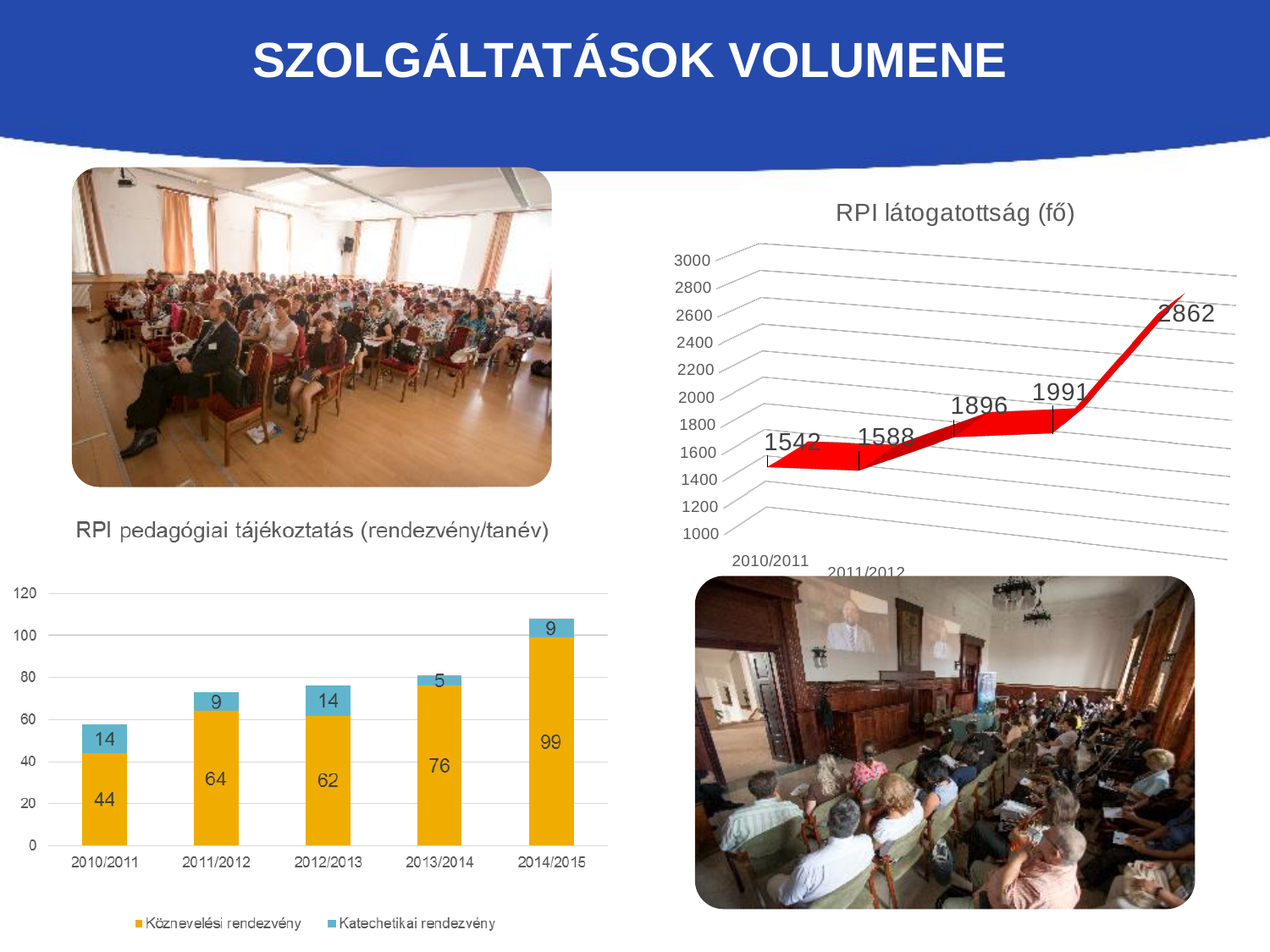
In the chart titled "RPI látogatottság (fő)", do the values rise or fall from left to right? Rise In the chart titled "RPI látogatottság (fő)", what is the highest value shown? 2862 In the chart titled "RPI látogatottság (fő)", what is the value for 2010/2011? 1542 In the chart titled "RPI pedagógiai tájékoztatás (rendezvény/tanév)", how many years are shown on the x axis? 5 In the chart titled "RPI pedagógiai tájékoztatás (rendezvény/tanév)", how many series does the legend list? 2 In the chart titled "RPI pedagógiai tájékoztatás (rendezvény/tanév)", which year has the highest Köznevelési rendezvény value? 2014/2015 In the chart titled "RPI pedagógiai tájékoztatás (rendezvény/tanév)", what is the value of Köznevelési rendezvény for 2014/2015? 99 In the chart titled "RPI pedagógiai tájékoztatás (rendezvény/tanév)", which year has the lowest Katechetikai rendezvény value? 2013/2014 What kind of chart is "RPI pedagógiai tájékoztatás (rendezvény/tanév)"? Stacked bar chart In the chart titled "RPI pedagógiai tájékoztatás (rendezvény/tanév)", what is the value of Katechetikai rendezvény for 2013/2014? 5 In the chart titled "RPI pedagógiai tájékoztatás (rendezvény/tanév)", what is the total of the stacked bar for 2011/2012? 73 In the chart titled "RPI pedagógiai tájékoztatás (rendezvény/tanév)", what is the difference between the Köznevelési rendezvény values for 2013/2014 and 2012/2013? 14